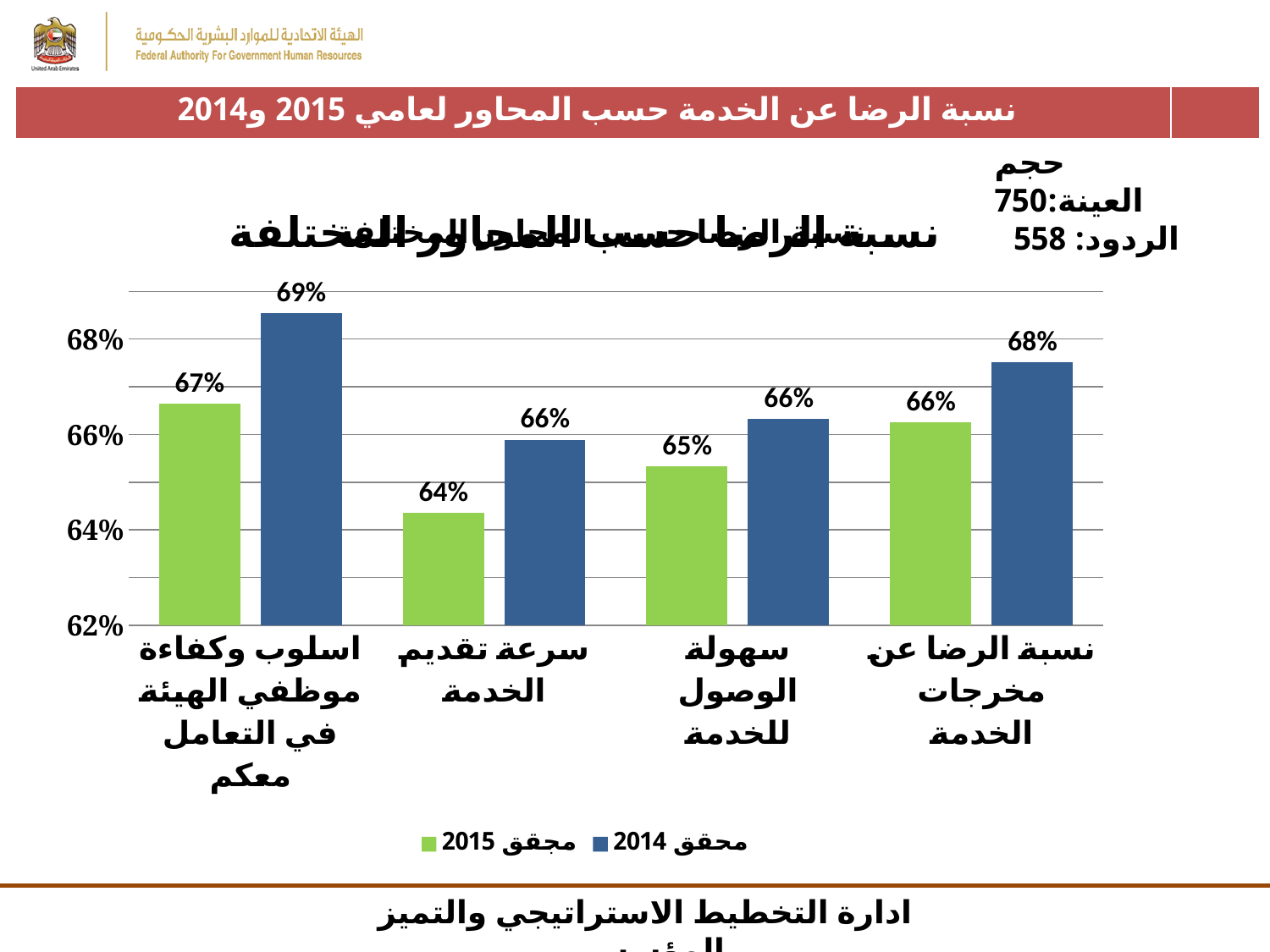
Which category has the highest 2014 (محقق 2014) value? اسلوب وكفاءة موظفي الهيئة في التعامل معكم Which colour represents محقق 2015 in the legend? green What kind of chart is shown on the slide? bar chart What is the difference between the 2014 and 2015 values for سرعة تقديم الخدمة? 2% For سهولة الوصول للخدمة, which is larger: the 2014 value or the 2015 value? 2014 What is the 2015 (محقق 2015) value for سهولة الوصول للخدمة? 65% What is the 2014 (محقق 2014) value for اسلوب وكفاءة موظفي الهيئة في التعامل معكم? 69% Which category has the lowest 2015 (محقق 2015) value? سرعة تقديم الخدمة What is the 2014 (محقق 2014) value for نسبة الرضا عن مخرجات الخدمة? 68% How many categories are shown on the x axis? 4 How many series does the legend list? 2 What is the 2015 (محقق 2015) value for سرعة تقديم الخدمة? 64%